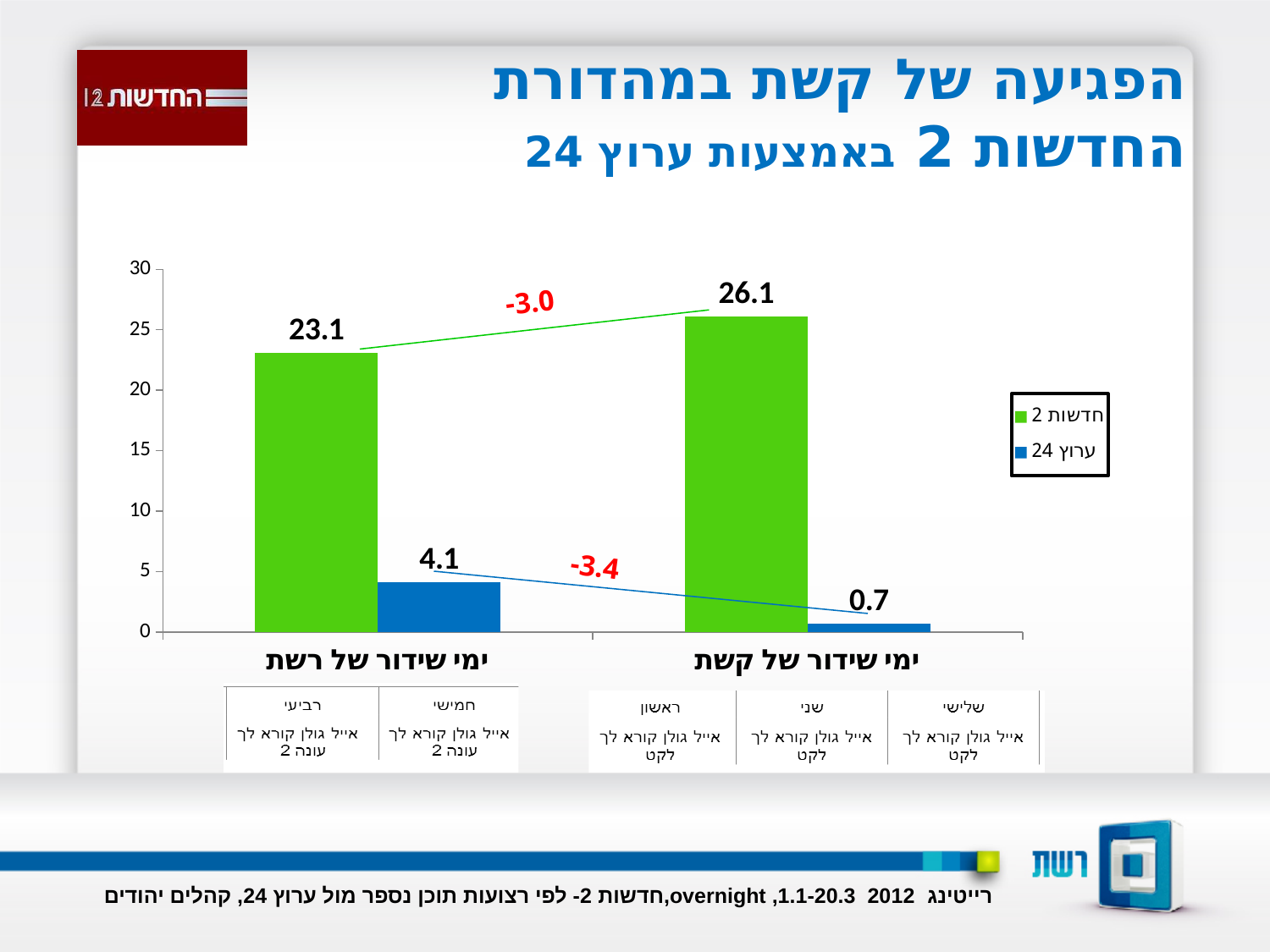
What is the value for חדשות 2 in the ימי שידור של רשת category? 23.1 Which bar has the highest value in the chart? חדשות 2 in ימי שידור של קשת (26.1) Which bar has the lowest value in the chart? ערוץ 24 in ימי שידור של קשת (0.7) What is the value for חדשות 2 in the ימי שידור של קשת category? 26.1 How many series does the legend list? 2 What is the difference between the ערוץ 24 values for ימי שידור של רשת and ימי שידור של קשת? 3.4 What colour represents the ערוץ 24 series in the chart? blue What is the value for ערוץ 24 in the ימי שידור של קשת category? 0.7 What is the value for ערוץ 24 in the ימי שידור של רשת category? 4.1 What is the difference between the חדשות 2 values for ימי שידור של קשת and ימי שידור של רשת? 3.0 Which is larger: the ערוץ 24 value for ימי שידור של רשת or for ימי שידור של קשת? ימי שידור של רשת What type of chart is shown on the slide? bar chart